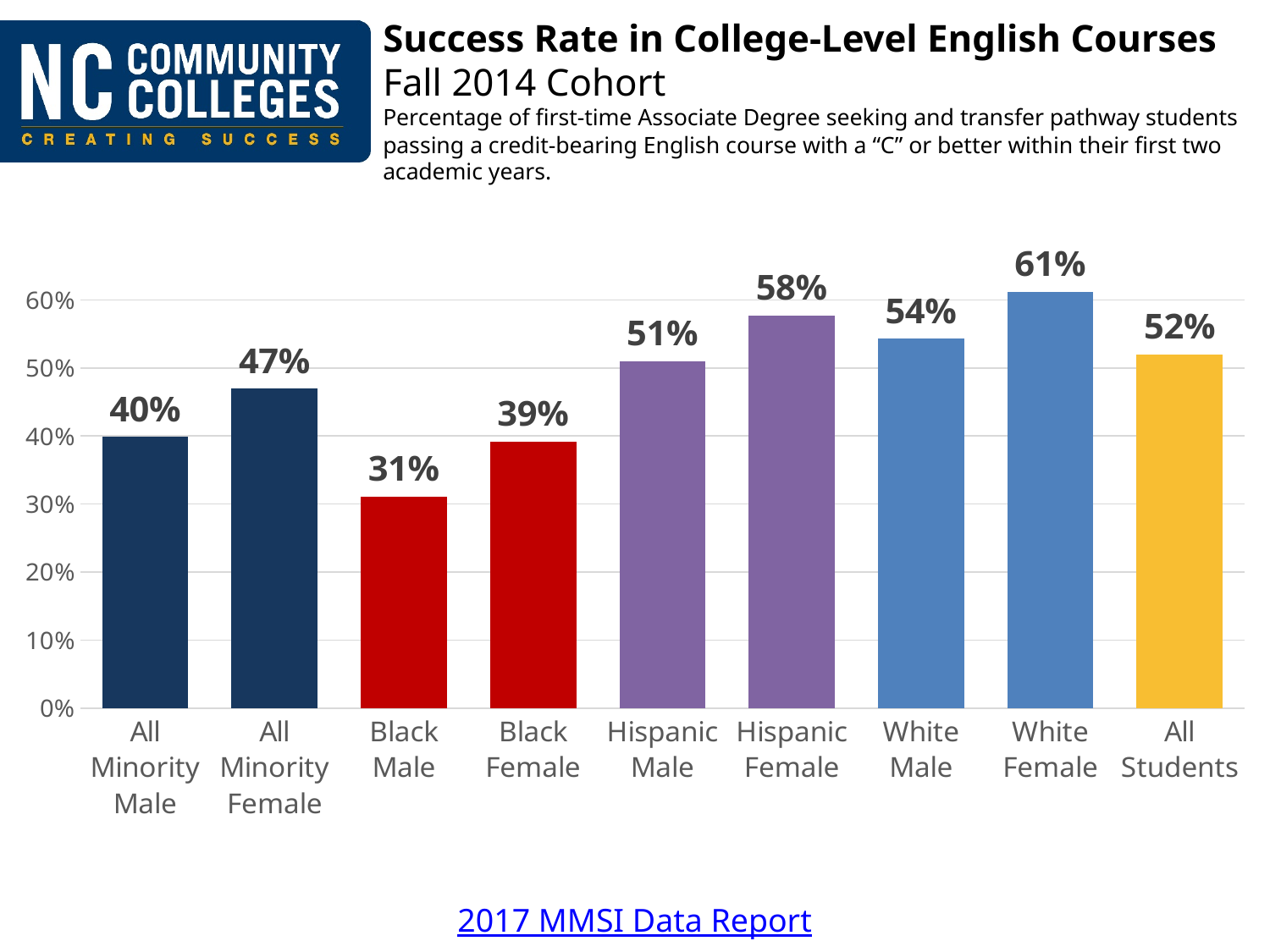
How many categories are shown on the chart? 9 Which has a higher success rate, Hispanic Male or White Male? White Male Is the success rate for Black Female students greater or less than 40%? less What is the success rate for All Students? 52% What is the success rate for Hispanic Female students? 58% Which category has the lowest success rate? Black Male Which category has the highest success rate? White Female What is the title of the chart? Success Rate in College-Level English Courses What is the success rate for Black Male students? 31% What kind of chart is shown on the slide? Bar chart What is the difference between the success rates of All Minority Female and All Minority Male students? 7 percentage points What is the difference between the success rates of White Female and Black Male students? 30 percentage points